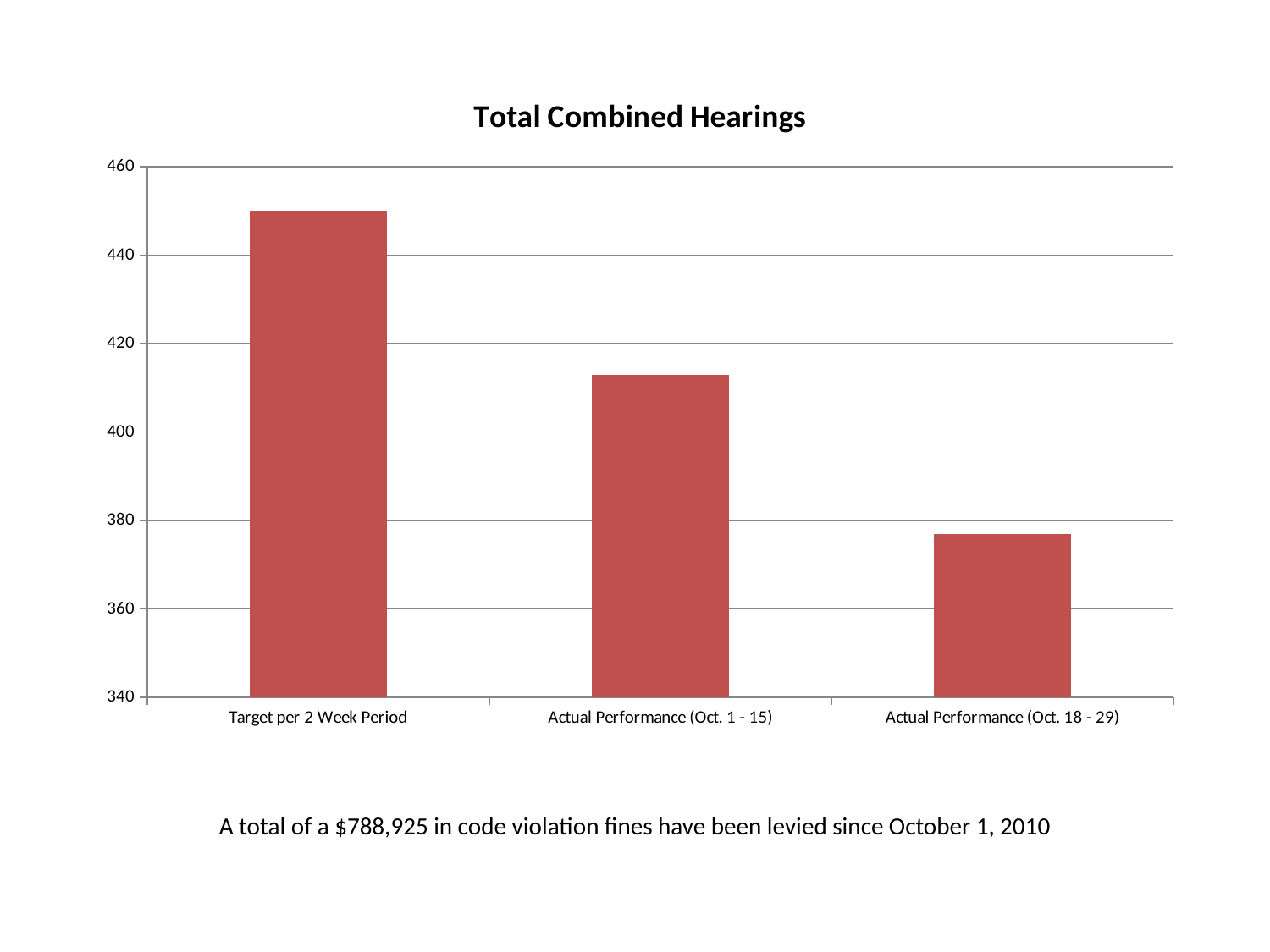
Is the value for Actual Performance (Oct. 18 - 29) greater or less than 400? less Do the values rise or fall from left to right across the categories? fall What kind of chart is shown on the slide? bar chart Which category has the lowest value? Actual Performance (Oct. 18 - 29) Is the value for Actual Performance (Oct. 1 - 15) greater or less than 400? greater Which category has the highest value? Target per 2 Week Period Which is larger, the value for Actual Performance (Oct. 1 - 15) or Actual Performance (Oct. 18 - 29)? Actual Performance (Oct. 1 - 15) Is the value for Target per 2 Week Period greater or less than 440? greater What is the title of the chart? Total Combined Hearings How many categories are plotted in the chart? 3